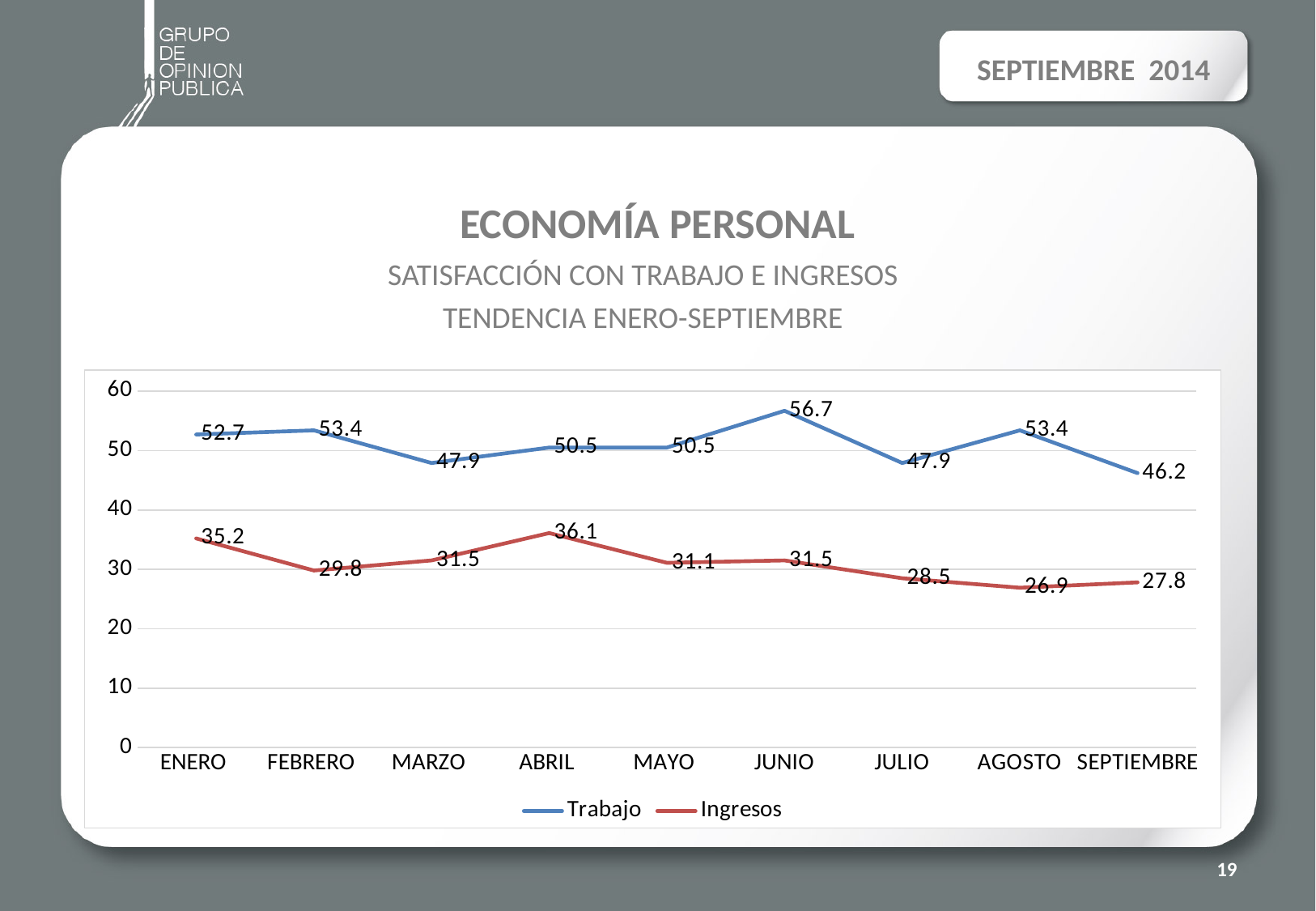
What is the value for Trabajo in JUNIO? 56.7 What kind of chart is shown on the slide? line chart What is the value for Ingresos in SEPTIEMBRE? 27.8 Does the Ingresos series rise or fall from ABRIL to AGOSTO? fall Is the value for Ingresos in JULIO greater or less than 30? less What is the difference between Trabajo and Ingresos in ENERO? 17.5 In which month is the Ingresos series lowest? AGOSTO Which is larger, the Trabajo value in FEBRERO or the Trabajo value in SEPTIEMBRE? FEBRERO In which month is the Trabajo series highest? JUNIO How many months are shown on the x axis? 9 How many series does the legend list? 2 What is the value for Ingresos in ABRIL? 36.1